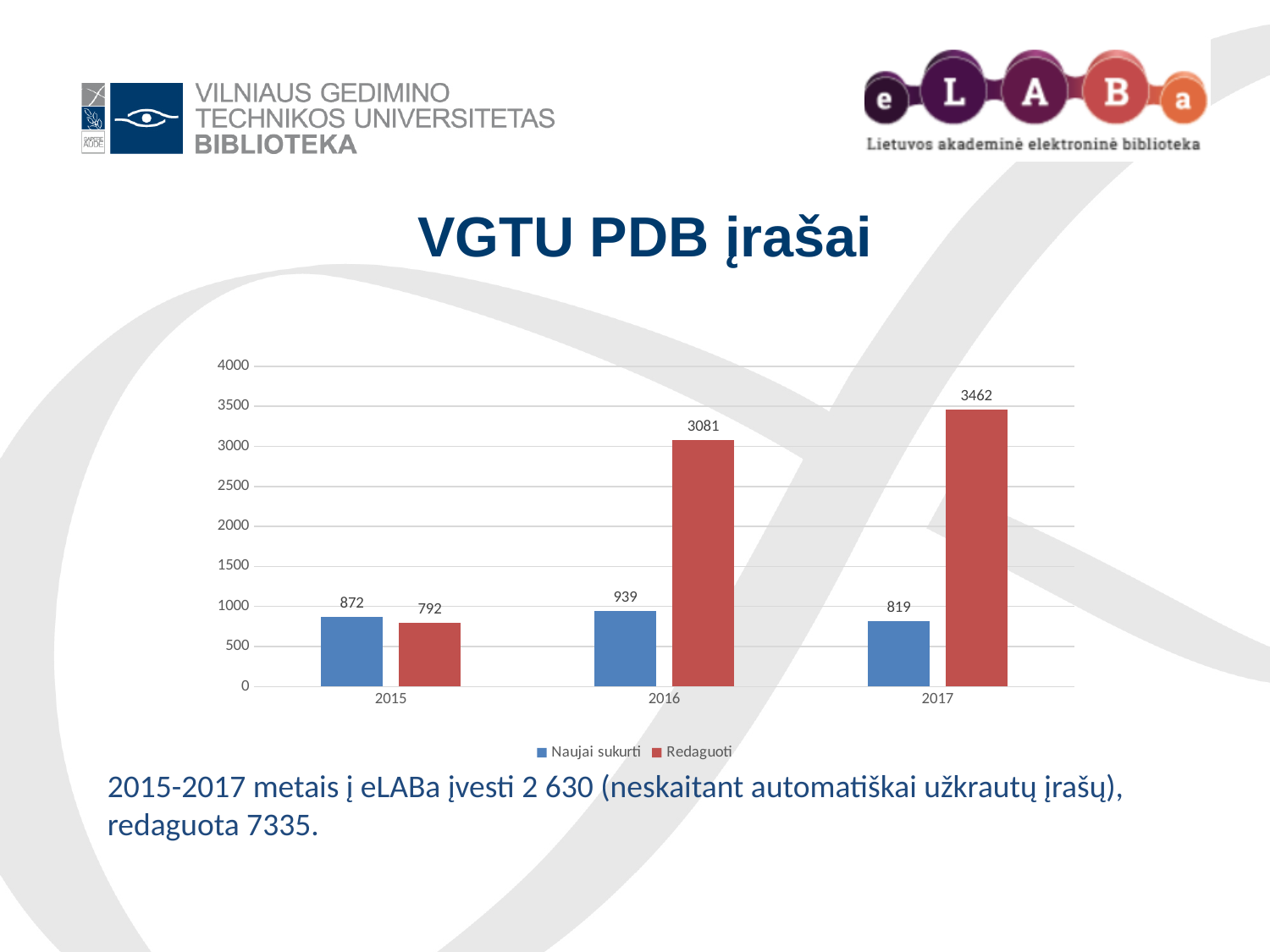
Which year has the highest value for Naujai sukurti? 2016 Does the Redaguoti series rise or fall from 2015 to 2017? rise How many years are shown on the x axis? 3 Which is larger in 2015, Naujai sukurti or Redaguoti? Naujai sukurti What is the difference between Redaguoti and Naujai sukurti in 2017? 2643 What is the value for Redaguoti in 2016? 3081 How many series does the legend list? 2 Is the value for Redaguoti in 2016 greater or less than 3000? greater What kind of chart is shown on the slide? bar chart Which year has the lowest value for Redaguoti? 2015 What is the value for Naujai sukurti in 2015? 872 What is the value for Redaguoti in 2017? 3462